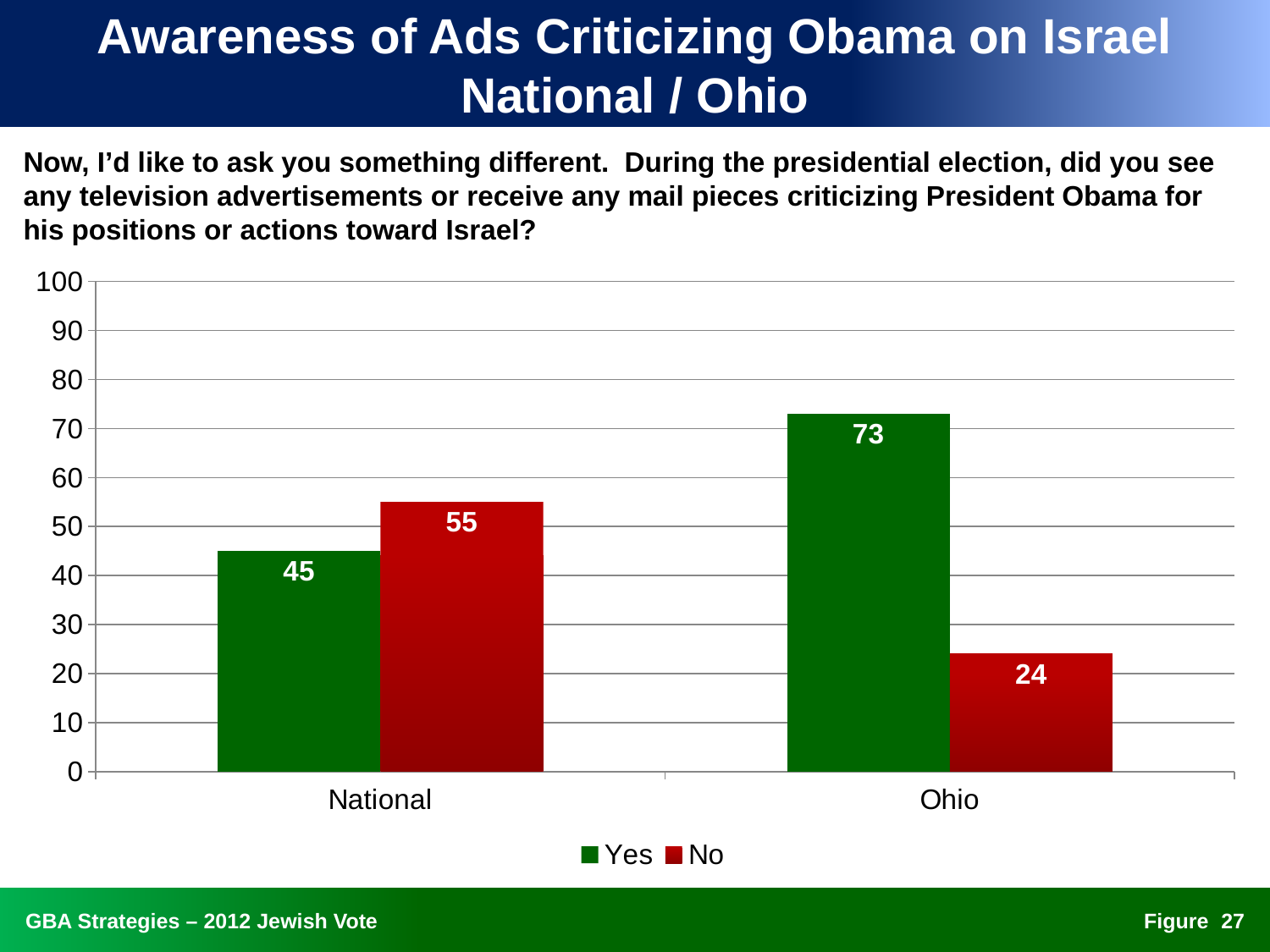
What is the value for No in the Ohio category? 24 What is the value for No in the National category? 55 Is the Yes value for Ohio greater or less than 70? greater What colour are the Yes bars? Green What is the value for Yes in the National category? 45 Which category has the lowest No value? Ohio What is the difference between the Yes values for Ohio and National? 28 Which category has the highest Yes value? Ohio In the National category, which is larger, Yes or No? No How many series does the legend list? 2 How many categories are shown on the x axis? 2 What kind of chart is shown on the slide? Bar chart